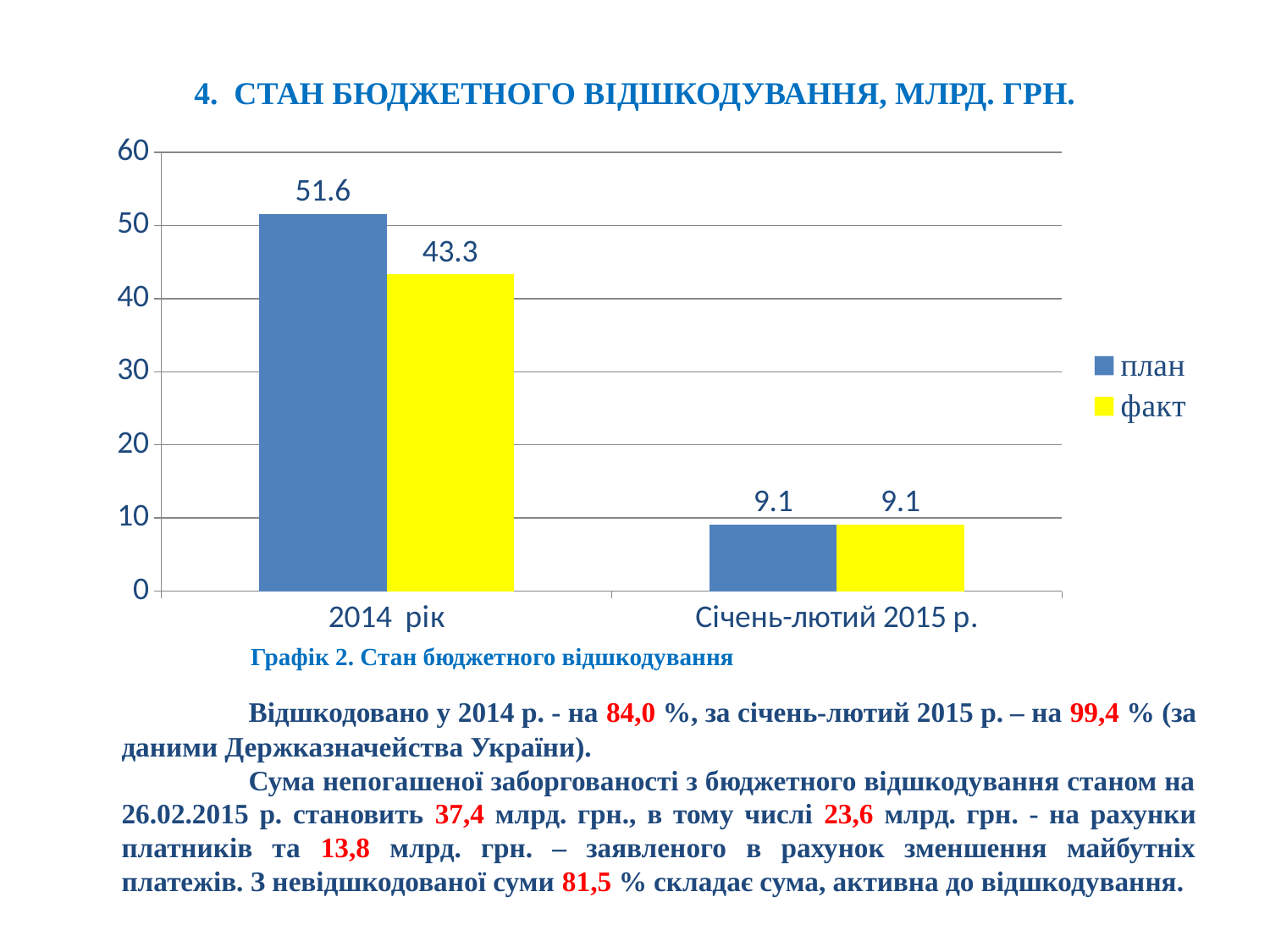
Which category has the highest "план" value? 2014 рік For "2014 рік", which is larger: "план" or "факт"? план Which colour represents the "факт" series? yellow How many categories are shown on the x axis? 2 What is the value of "факт" for "Січень-лютий 2015 р."? 9.1 What is the value of "план" for "Січень-лютий 2015 р."? 9.1 What kind of chart is shown on the slide? bar chart What is the difference between "план" and "факт" for "2014 рік"? 8.3 Which category has the lowest "факт" value? Січень-лютий 2015 р. What is the value of "факт" for "2014 рік"? 43.3 What is the value of "план" for "2014 рік"? 51.6 How many series does the legend list? 2